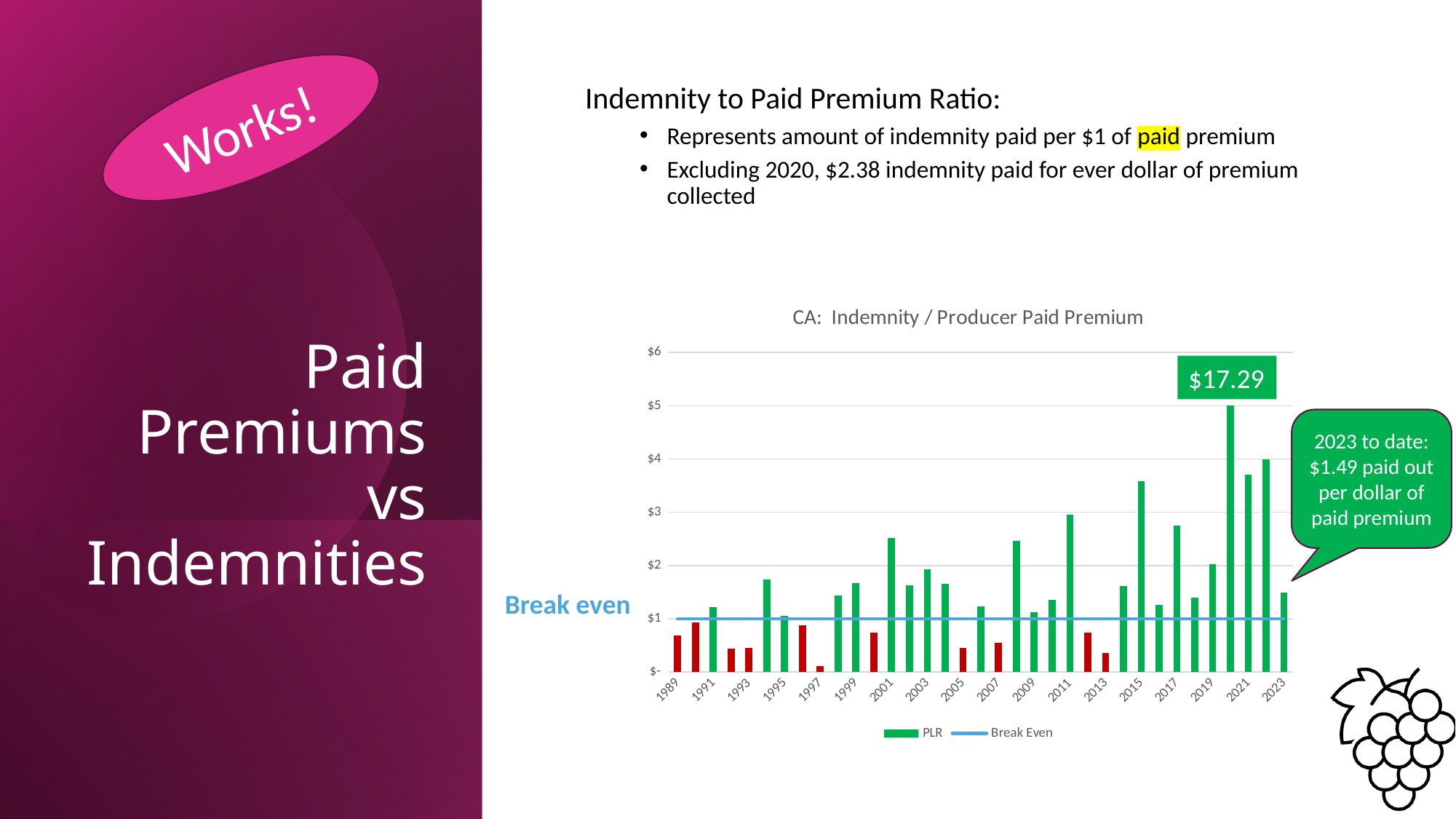
How many years (bars) are plotted in the chart? 35 At what value is the Break Even line drawn? $1 What is the labelled value for 2020 in the chart? $17.29 Is the value for 2015 greater or less than $3? greater How many series does the chart legend list? 2 According to the callout, what is the 2023 to date value paid out per dollar of paid premium? $1.49 Which is larger, the value for 2015 or the value for 2017? 2015 Is the value for 2001 greater or less than $2? greater Which year has the highest value in the chart? 2020 What type of chart is shown on the slide? bar chart What is the title of the chart? CA: Indemnity / Producer Paid Premium Is the value for 1997 greater or less than $1? less